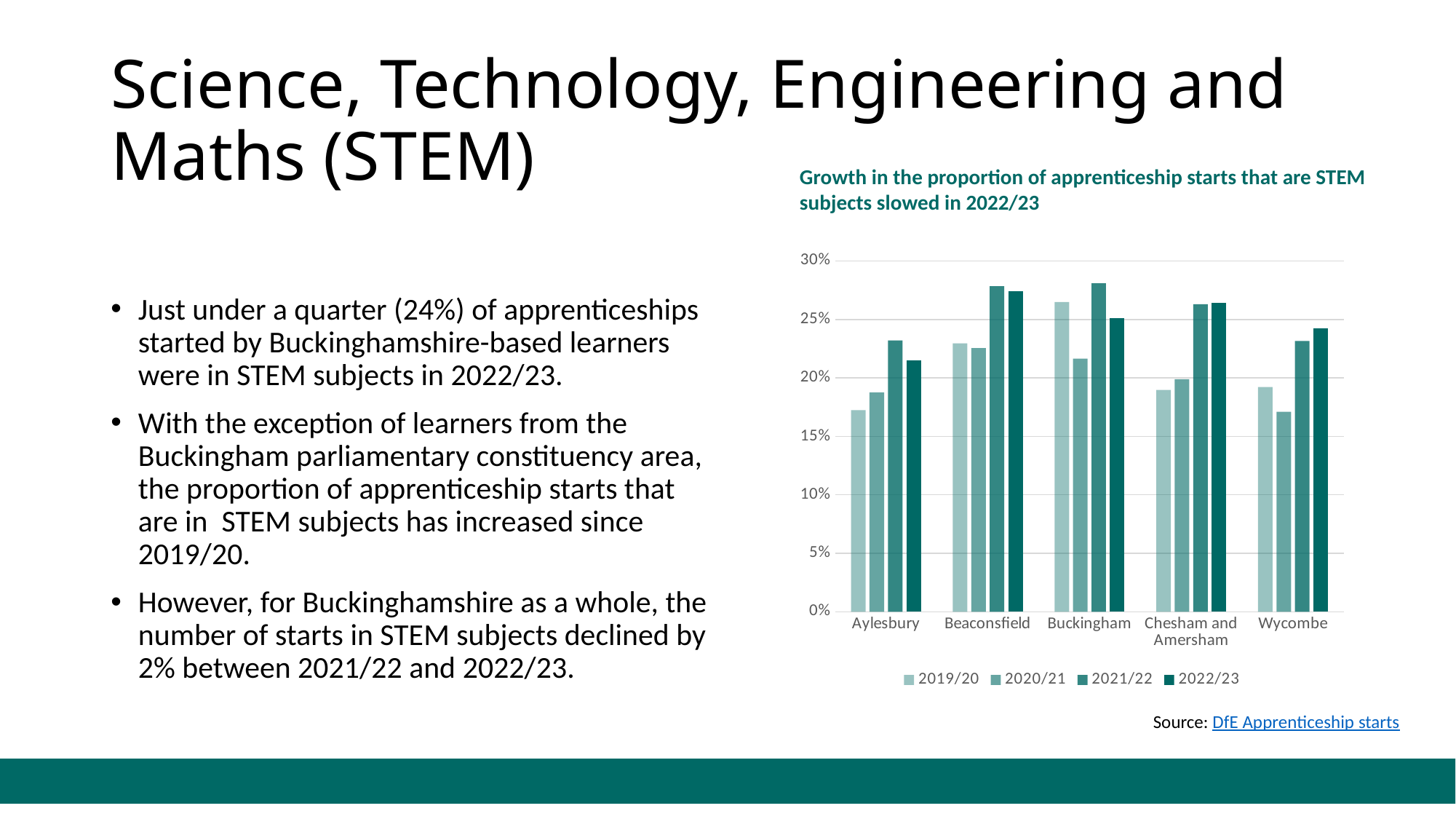
Is the 2020/21 value for Wycombe greater or less than 20%? less What kind of chart is shown on the slide? Bar chart For Aylesbury, does the value rise or fall from 2021/22 to 2022/23? Fall How many constituencies are shown on the x axis of the chart? 5 Is the 2021/22 value for Buckingham greater or less than 25%? greater Is the 2022/23 value for Beaconsfield greater or less than 25%? greater What is the title of the chart? Growth in the proportion of apprenticeship starts that are STEM subjects slowed in 2022/23 Which constituency has the lowest 2019/20 value? Aylesbury For Wycombe, which is larger: the 2021/22 value or the 2022/23 value? 2022/23 For Buckingham, which is larger: the 2019/20 value or the 2020/21 value? 2019/20 How many series does the legend of the chart list? 4